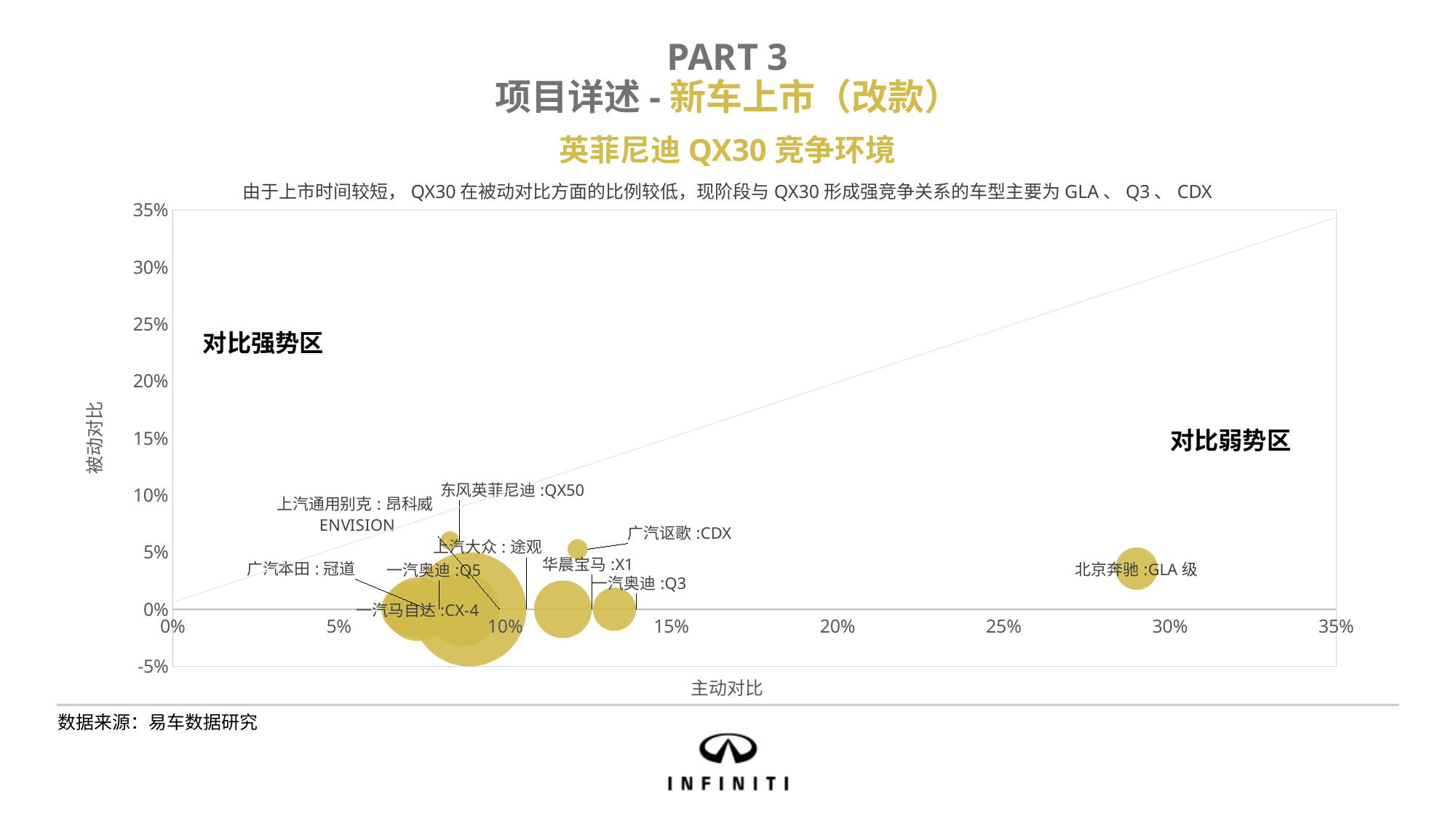
Which has a larger 主动对比 value, 北京奔驰:GLA级 or 广汽讴歌:CDX? 北京奔驰:GLA级 Which has a larger 主动对比 value, 一汽奥迪:Q3 or 广汽本田:冠道? 一汽奥迪:Q3 What is the title of the chart? 英菲尼迪 QX30 竞争环境 What kind of chart is shown on the slide? bubble chart Which car model has the highest value on the horizontal axis (主动对比)? 北京奔驰:GLA级 What is the label of the vertical axis of the chart? 被动对比 Is the 主动对比 value for 东风英菲尼迪:QX50 greater or less than 10%? less Is the 被动对比 value for 东风英菲尼迪:QX50 greater or less than 10%? less Is the 主动对比 value for 广汽讴歌:CDX greater or less than 15%? less How many labeled bubbles (car models) are plotted on the chart? 10